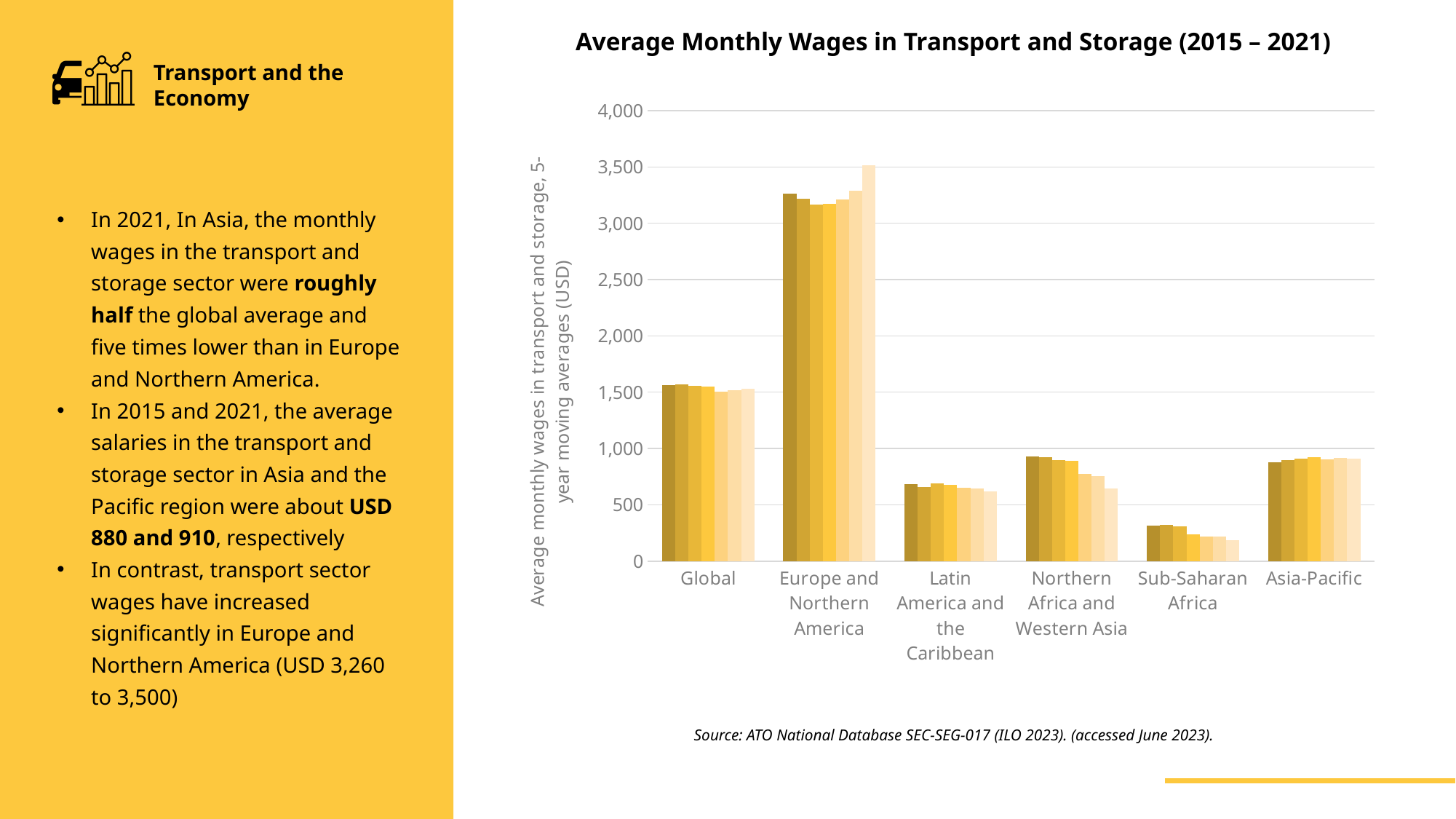
Are the values for Europe and Northern America greater or less than 3,000? greater What is the title of the chart? Average Monthly Wages in Transport and Storage (2015 – 2021) Which region has the highest average monthly wages in transport and storage in the chart? Europe and Northern America Are the values for Asia-Pacific greater or less than 1,000? less Are the values for Sub-Saharan Africa greater or less than 500? less How many bars are shown for each region in the chart? 7 Which region has higher average monthly wages: Northern Africa and Western Asia or Latin America and the Caribbean? Northern Africa and Western Asia How many regions (categories) are shown on the x axis of the chart? 6 Do the bars for Northern Africa and Western Asia rise or fall from left to right across the years? fall Which region has the lowest average monthly wages in transport and storage in the chart? Sub-Saharan Africa What kind of chart is shown on the slide? Bar chart